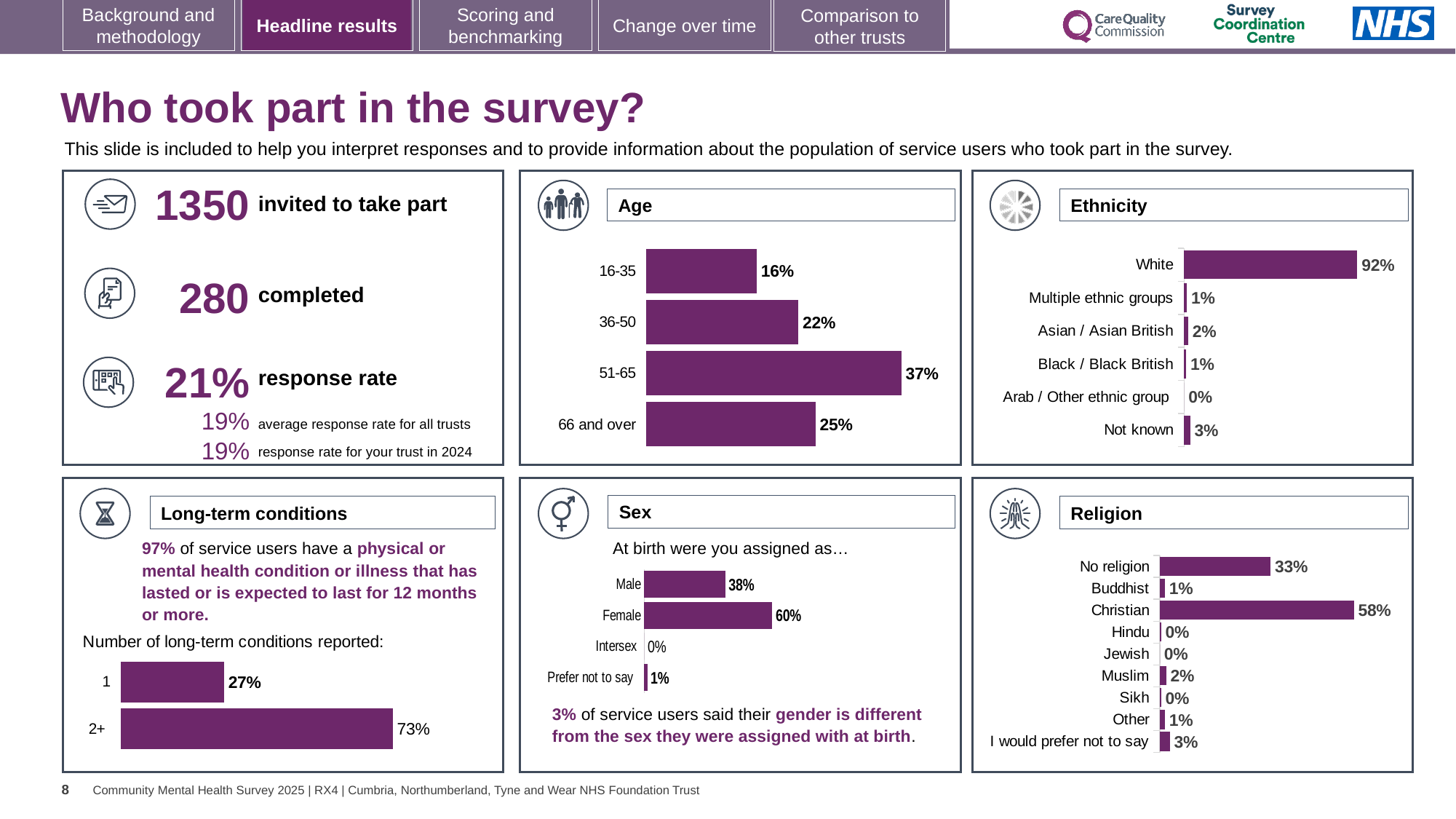
In the Age chart, what is the difference between the 66 and over group and the 36-50 group? 3% In the Religion chart, which religion category has the highest percentage? Christian What type of chart is used in the Age panel? Bar chart In the Age chart, what percentage of respondents were aged 51-65? 37% In the Ethnicity chart, which is larger: Asian / Asian British or Not known? Not known In the Sex chart, what is the difference between Female and Male? 22% In the Sex chart, what percentage of respondents were assigned Female at birth? 60% In the Long-term conditions chart, what percentage of service users reported 2+ long-term conditions? 73% In the Age chart, which age group has the lowest percentage? 16-35 In the Ethnicity chart, what percentage of respondents were White? 92% In the Religion chart, what percentage of respondents said No religion? 33% How many ethnicity categories are shown in the Ethnicity chart? 6